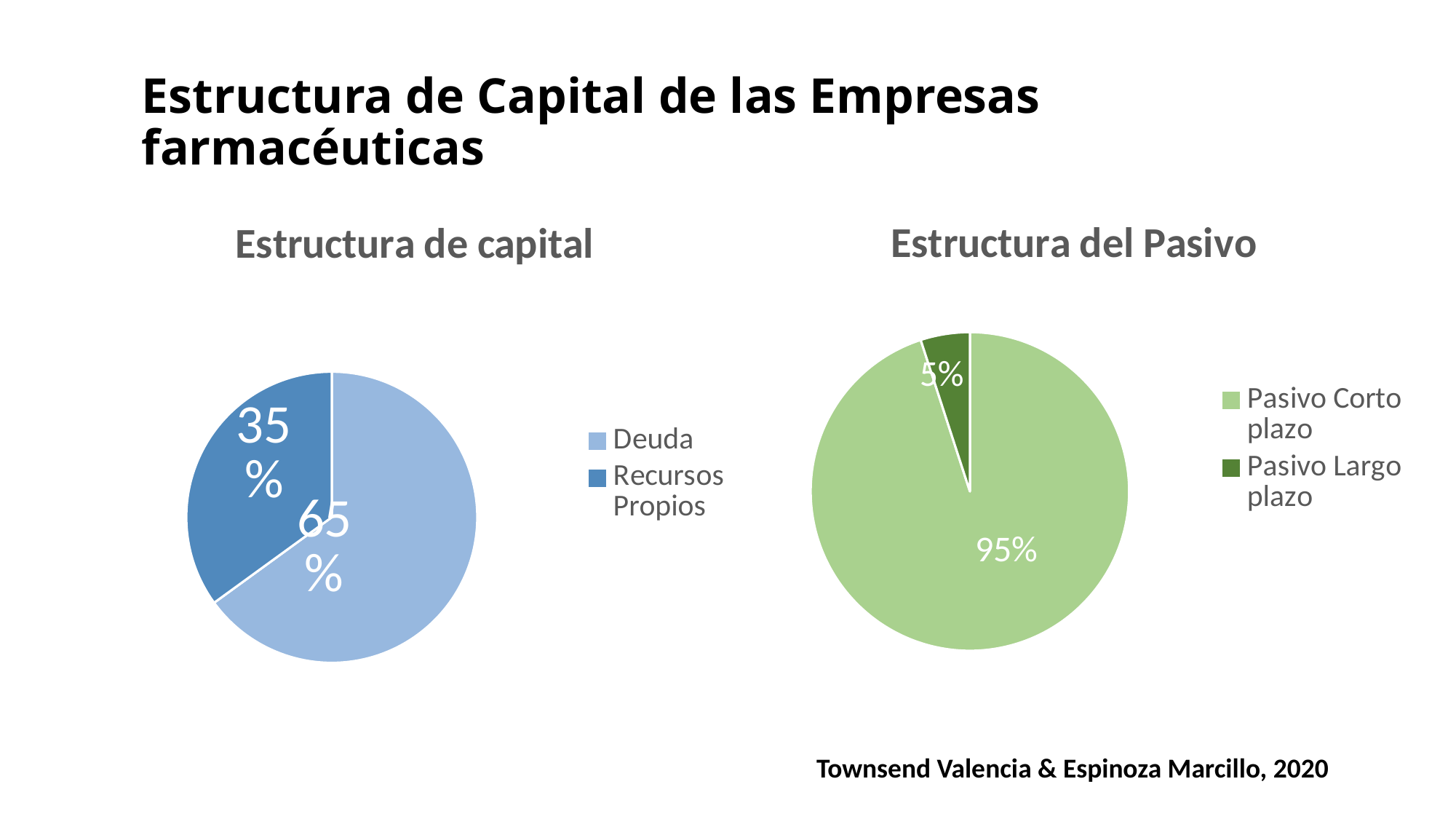
In the 'Estructura del Pasivo' chart, what is the difference between the Pasivo Corto plazo and Pasivo Largo plazo shares? 90% In the 'Estructura de capital' chart, which slice is the largest? Deuda What kind of chart is 'Estructura de capital'? Pie chart In the 'Estructura del Pasivo' chart, what share does Pasivo Corto plazo have? 95% In the 'Estructura de capital' chart, what is the difference between the Deuda and Recursos Propios shares? 30% In the 'Estructura del Pasivo' chart, how many entries does the legend list? 2 In the 'Estructura del Pasivo' chart, which slice is the smallest? Pasivo Largo plazo In the 'Estructura del Pasivo' chart, what share does Pasivo Largo plazo have? 5% In the 'Estructura del Pasivo' chart, what colour is the Pasivo Largo plazo slice? Dark green In the 'Estructura de capital' chart, how many slices does the pie have? 2 In the 'Estructura de capital' chart, what share does Recursos Propios have? 35%